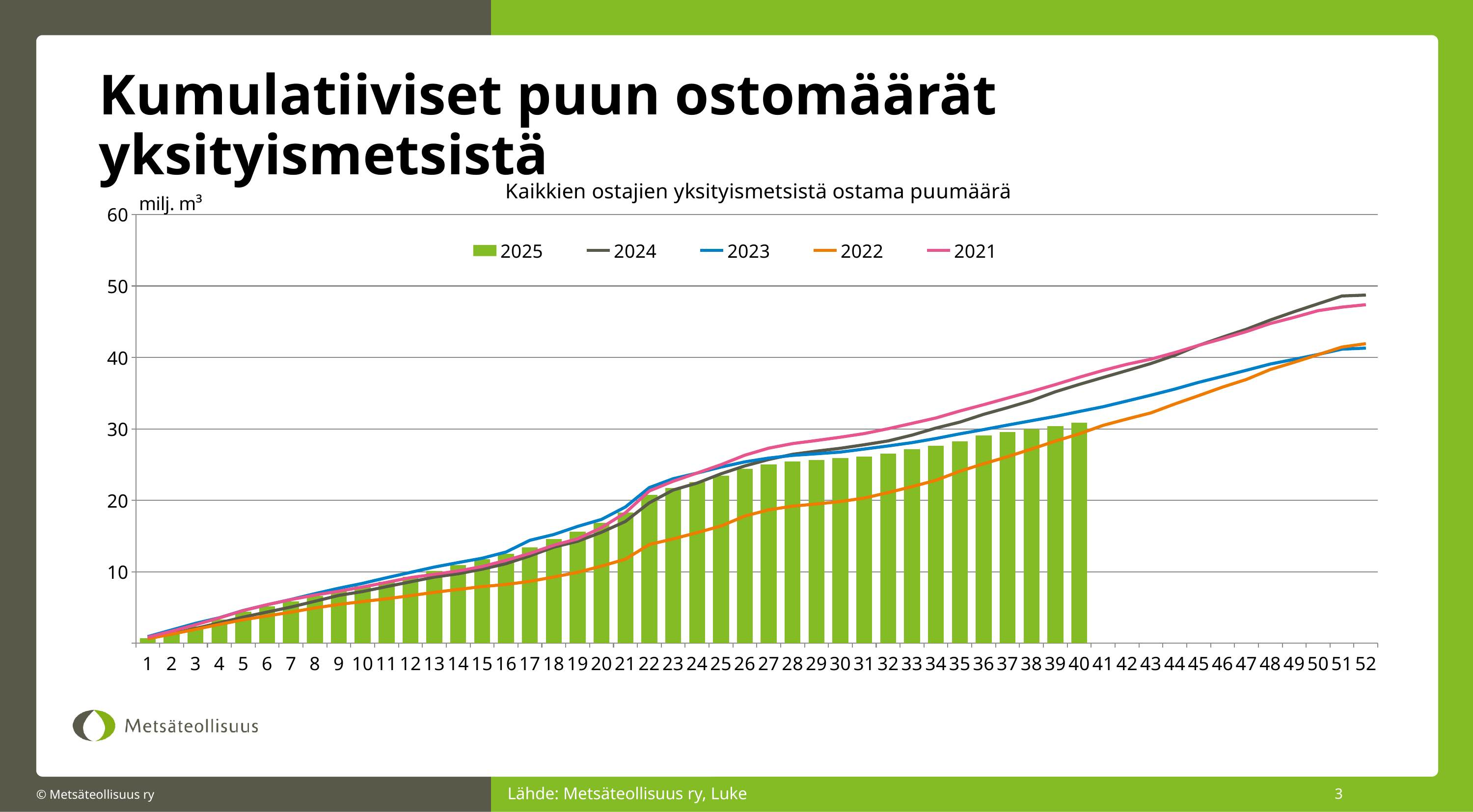
Which series has the lowest value at week 30? 2022 Is the value for 2024 at week 52 greater or less than 50? less Which series is drawn as bars rather than a line? 2025 What is the chart's title? Kaikkien ostajien yksityismetsistä ostama puumäärä Up to which week do the 2025 bars extend? 40 How many weeks are shown on the x axis? 52 Which series has the highest value at week 52? 2024 How many series does the legend list? 5 Do the values for 2024 rise or fall along the x axis? Rise What kind of chart is this? A combined bar and line chart Is the value for 2022 at week 28 greater or less than 20? less Is the value for 2025 at week 40 greater or less than 30? greater